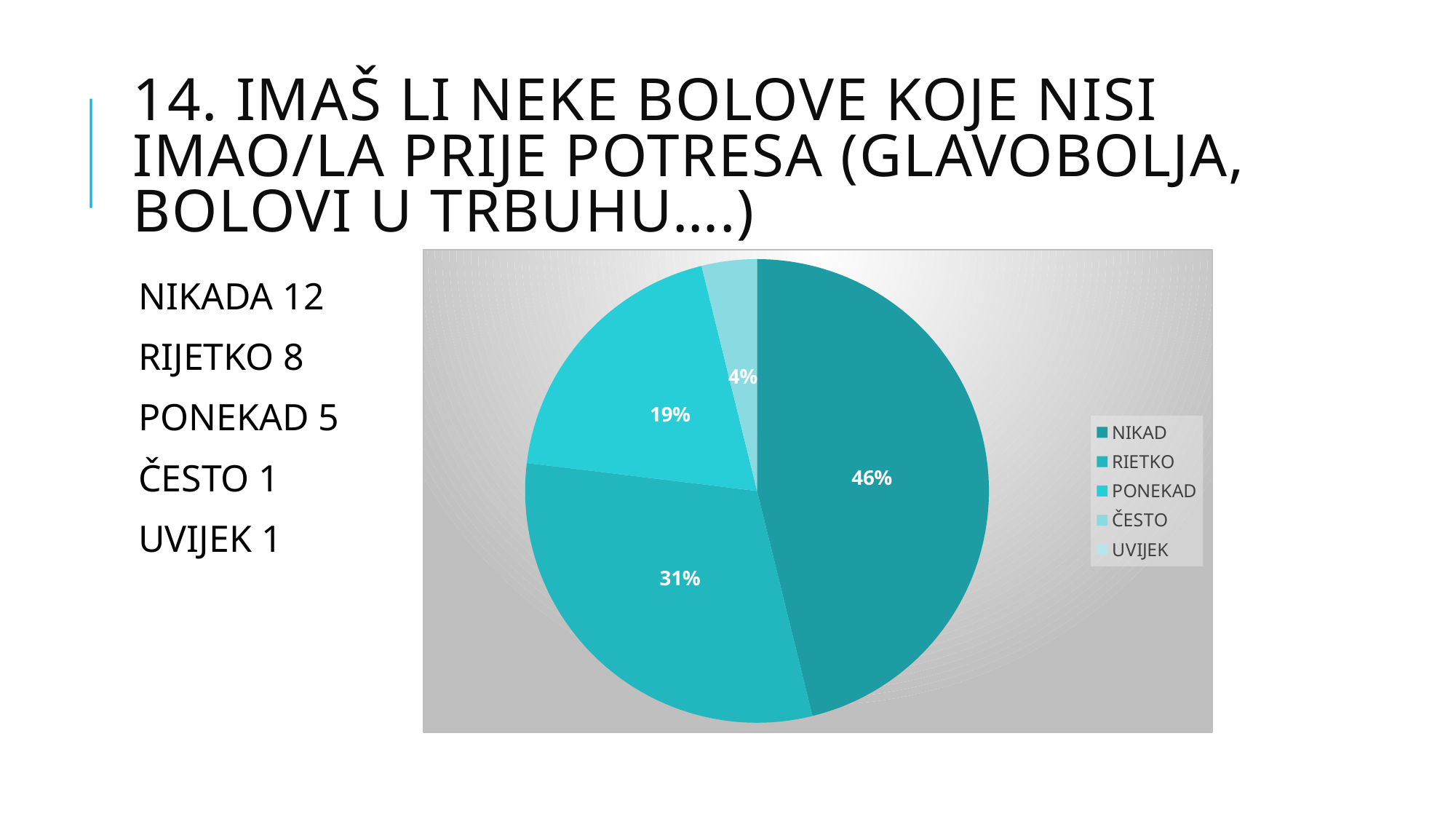
What percentage is shown for the ČESTO slice? 4% Which category has the largest slice of the pie? NIKAD Which category is listed last in the chart legend? UVIJEK What percentage is shown for the RIETKO slice? 31% Which of the labelled slices is the smallest? ČESTO Which slice is larger, RIETKO or PONEKAD? RIETKO What percentage is shown for the PONEKAD slice? 19% What percentage of the pie does the NIKAD slice represent? 46% What is the difference in percentage points between the NIKAD and RIETKO slices? 15 How many entries does the chart legend list? 5 What kind of chart is shown on the slide? Pie chart What is the difference in percentage points between the PONEKAD and ČESTO slices? 15